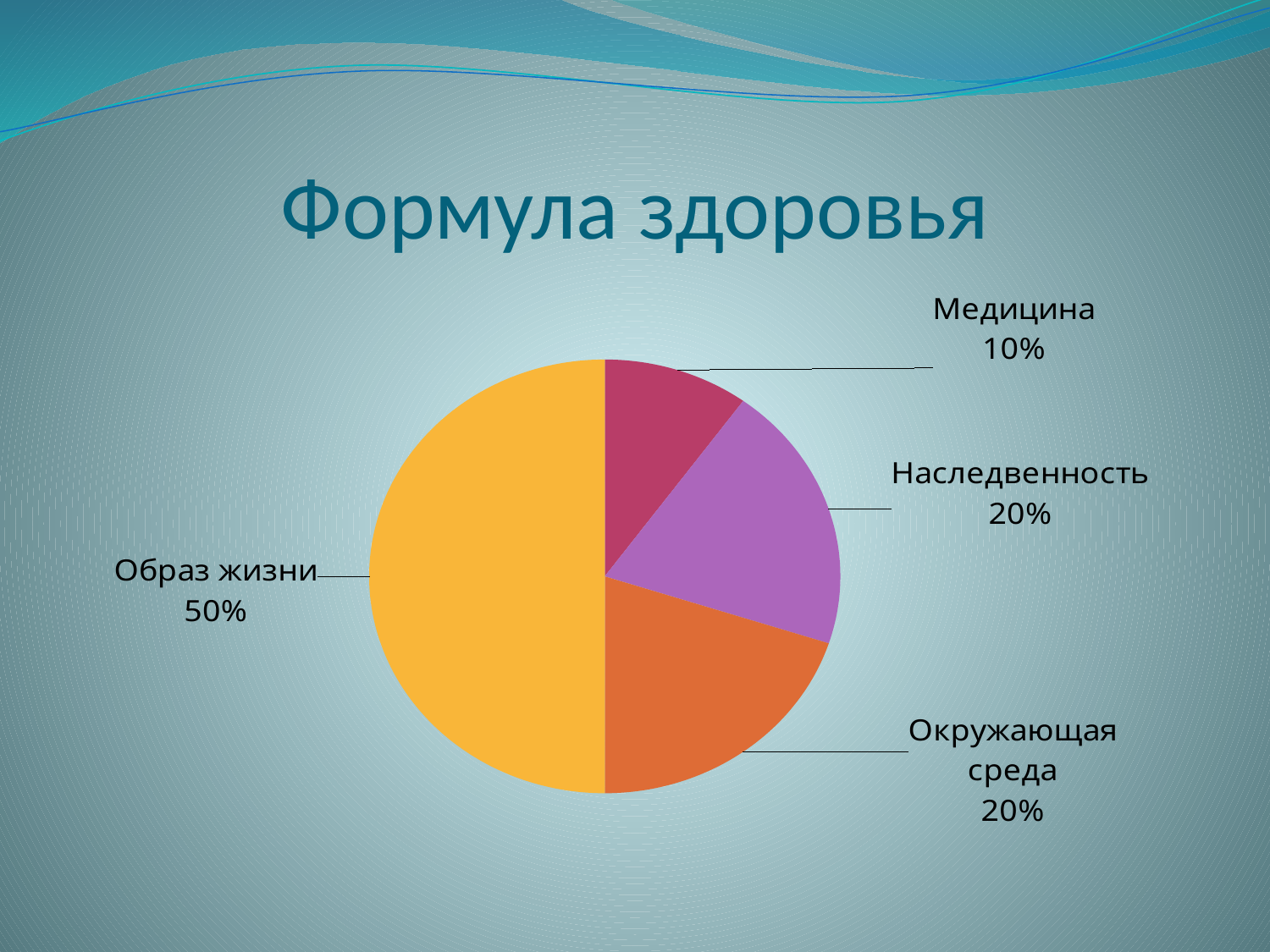
Which is larger, the value for Образ жизни or the value for Окружающая среда? Образ жизни What is the difference between the values for Наследственность and Медицина? 10% What kind of chart is shown on the slide? Pie chart Which category has the largest slice of the pie? Образ жизни What is the difference between the values for Образ жизни and Медицина? 40% What is the value shown for Окружающая среда? 20% Which category has the smallest slice of the pie? Медицина What share of the pie does Образ жизни have? 50% What is the title of the slide? Формула здоровья What is the value shown for Наследственность? 20% What is the value shown for Медицина? 10% How many categories are shown in the pie chart? 4